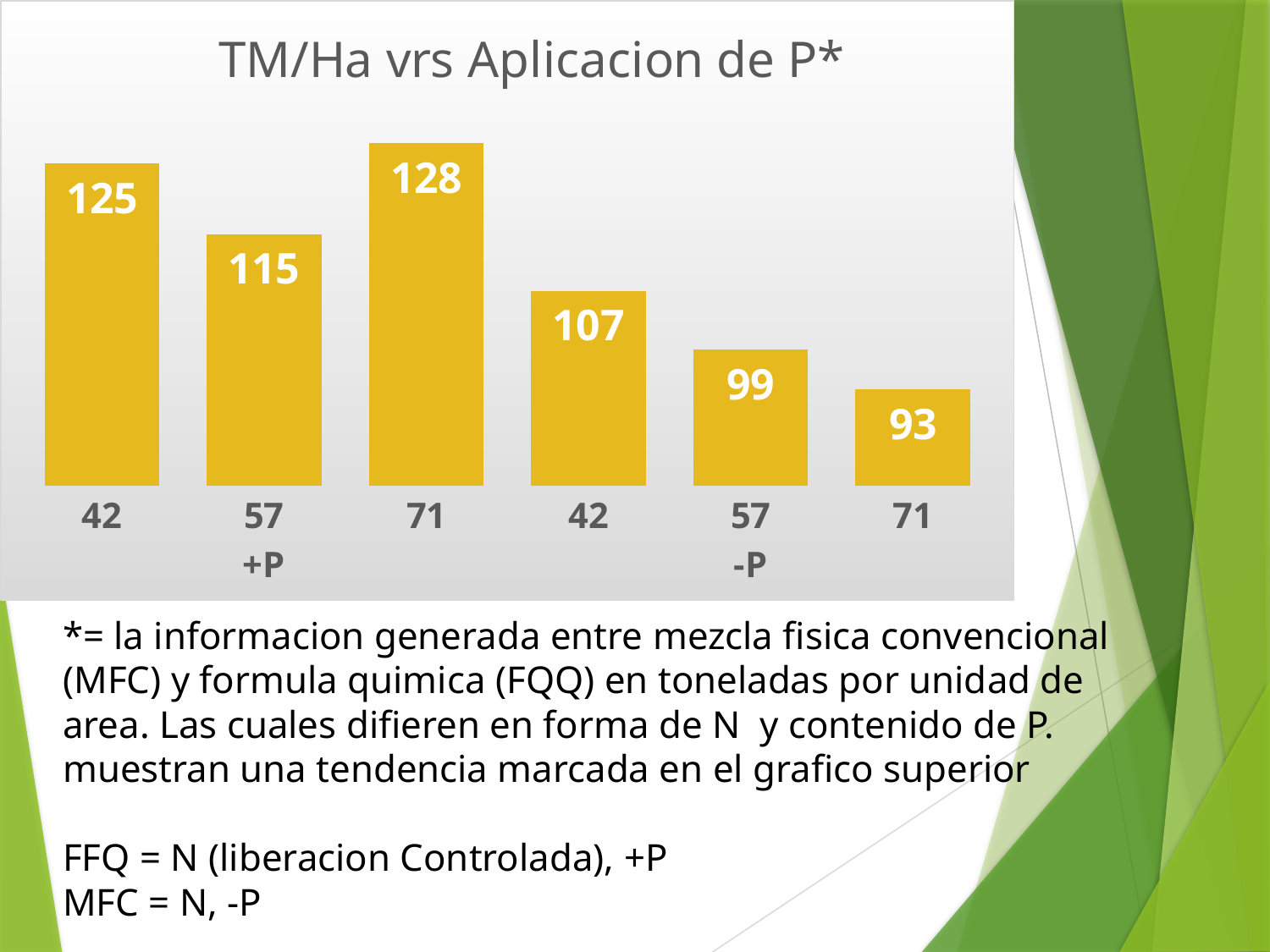
What is the value for 57 in the +P group? 115 How many bars are plotted in the chart? 6 What kind of chart is shown on the slide? Bar chart Which bar has the lowest value? 71 in the -P group (93) What is the value for 42 in the -P group? 107 What is the value for 71 in the -P group? 93 What is the title of the chart? TM/Ha vrs Aplicacion de P* What is the difference between the value for 71 in the +P group and the value for 71 in the -P group? 35 Which is larger, the value for 57 in the +P group or the value for 57 in the -P group? 57 in the +P group What is the difference between the value for 42 in the +P group and the value for 42 in the -P group? 18 Which bar has the highest value? 71 in the +P group (128) What is the value for 42 in the +P group? 125